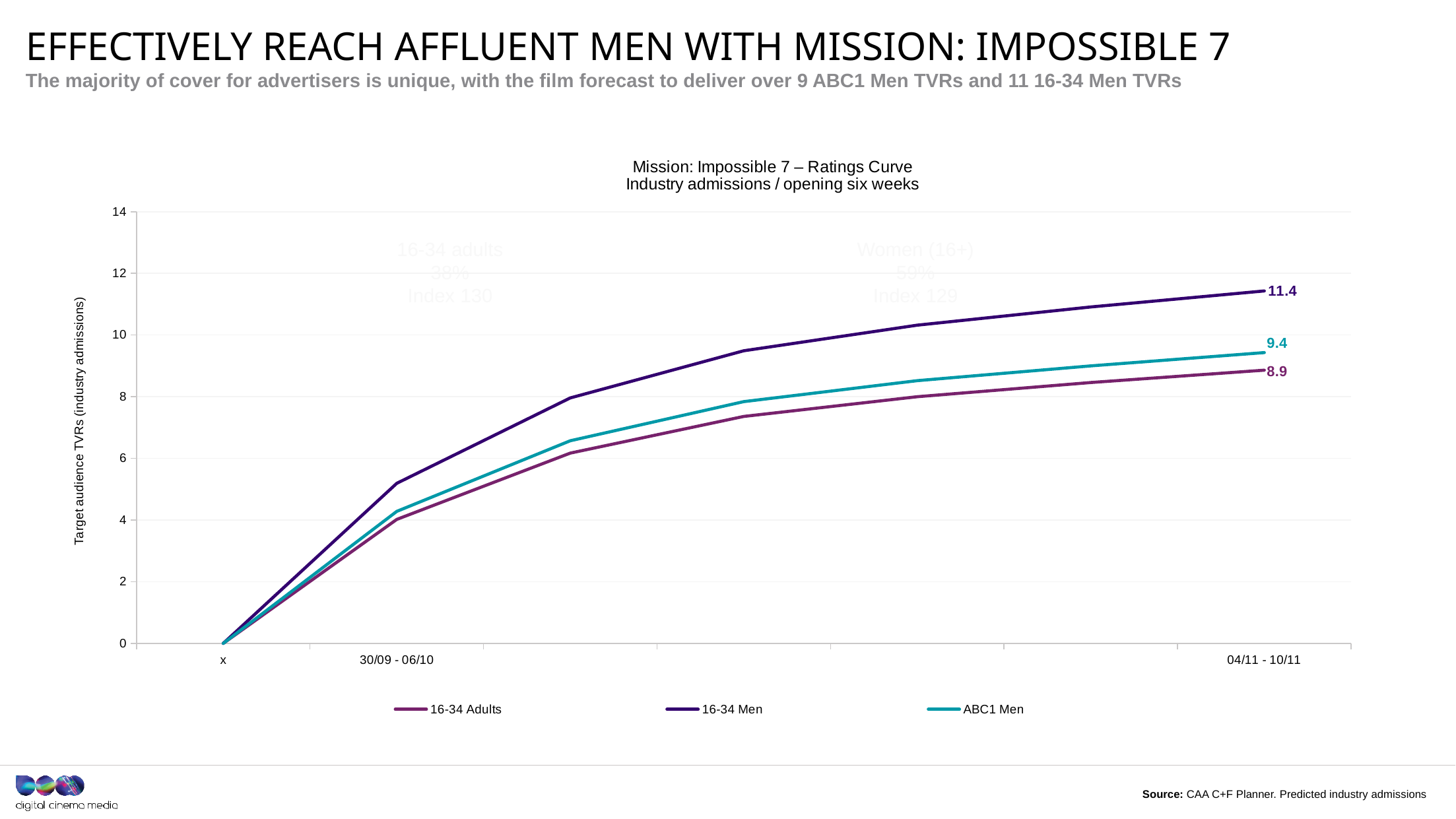
What is the final value shown for the ABC1 Men series? 9.4 What is the label on the vertical axis of the chart? Target audience TVRs (industry admissions) Is the value for 16-34 Men at 30/09 - 06/10 greater or less than 4? greater How many series does the legend list? 3 What type of chart is shown on the slide? Line chart Which series has the lowest final value? 16-34 Adults What is the final value shown for the 16-34 Men series? 11.4 Do the values for the 16-34 Men series rise or fall along the x axis? Rise What is the difference between the final values of 16-34 Men and ABC1 Men? 2.0 What is the final value shown for the 16-34 Adults series? 8.9 Which has a larger final value, ABC1 Men or 16-34 Adults? ABC1 Men Which series has the highest final value? 16-34 Men